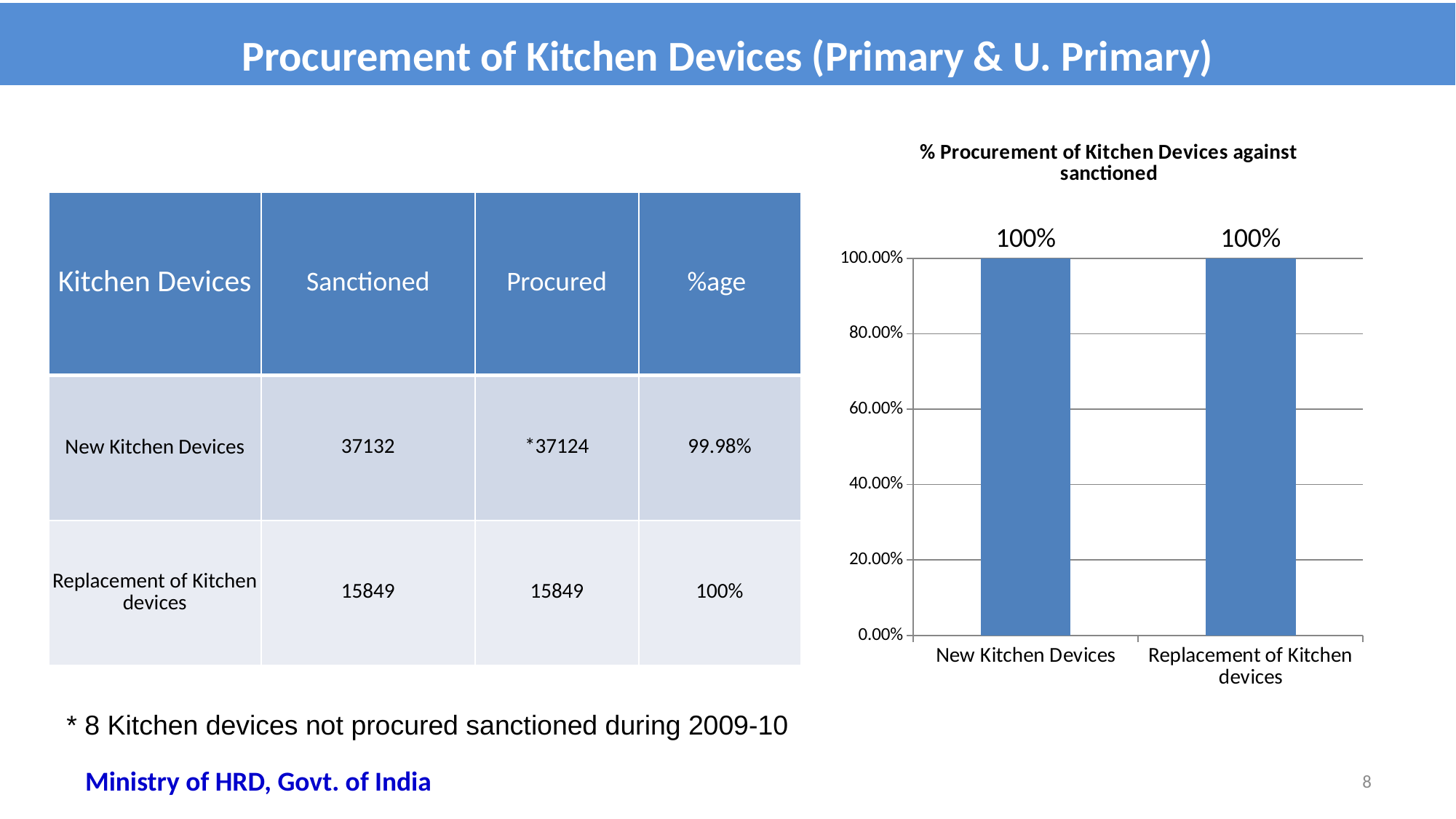
What is the difference between the values for New Kitchen Devices and Replacement of Kitchen devices in the chart? 0% What value is shown for Replacement of Kitchen devices in the chart? 100% Is the value for New Kitchen Devices greater or less than 80.00%? greater What value is shown for New Kitchen Devices in the chart? 100% Do the values in the chart rise, fall, or stay the same from New Kitchen Devices to Replacement of Kitchen devices? Stay the same What is the title of the chart? % Procurement of Kitchen Devices against sanctioned What is the highest tick value shown on the vertical axis of the chart? 100.00% How many categories are plotted in the chart? 2 What kind of chart is shown on the slide? Bar chart Is the value for Replacement of Kitchen devices greater or less than 60.00%? greater